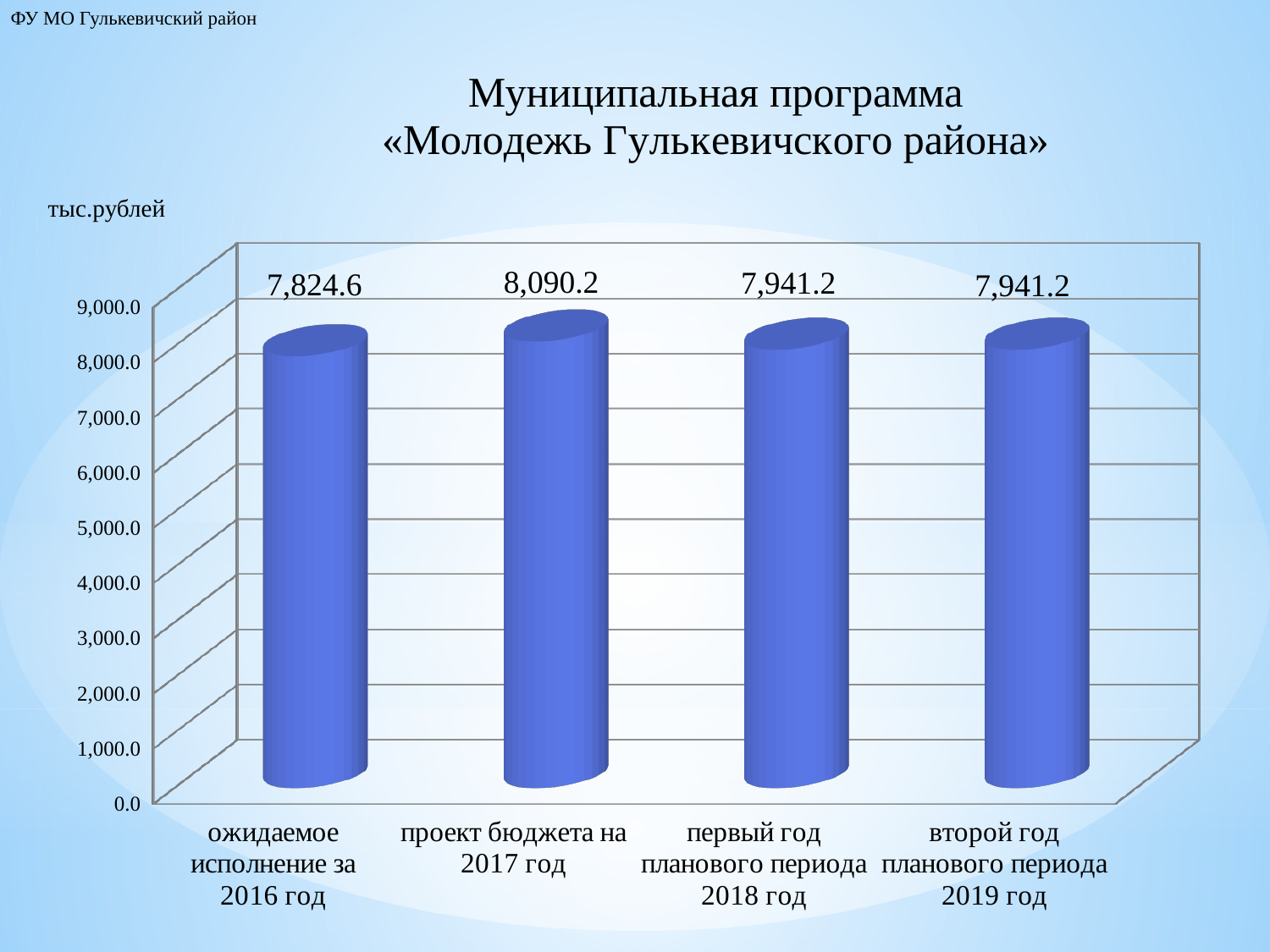
What is the value for «первый год планового периода 2018 год»? 7,941.2 What is the value for «проект бюджета на 2017 год»? 8,090.2 What is the difference between the value for 2017 and the value for 2016? 265.6 Which category has the highest value? проект бюджета на 2017 год Is the value for «ожидаемое исполнение за 2016 год» greater or less than 8,000.0? less What is the difference between the value for 2017 and the value for 2018? 149.0 How many categories are shown on the chart? 4 Which category has the lowest value? ожидаемое исполнение за 2016 год What is the value for «ожидаемое исполнение за 2016 год»? 7,824.6 Which is larger: the value for 2017 or the value for 2016? 2017 What kind of chart is shown on the slide? bar chart What unit is indicated above the chart? тыс.рублей